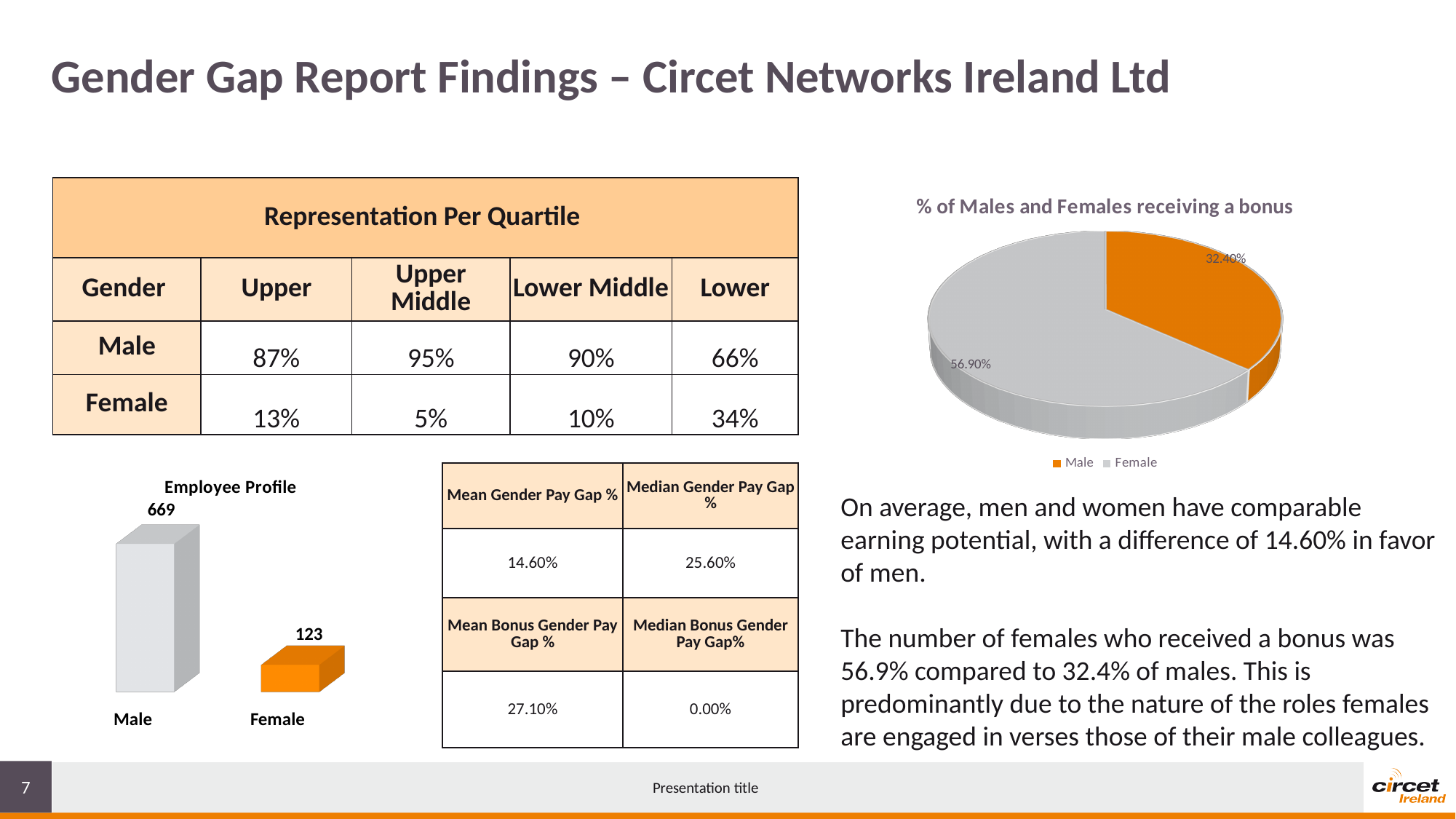
In the 'Employee Profile' chart, which category has the highest value? Male In the '% of Males and Females receiving a bonus' chart, what is the value for Male? 32.40% In the 'Employee Profile' chart, how many categories are shown? 2 In the 'Employee Profile' chart, what is the difference between the Male and Female values? 546 What kind of chart is the 'Employee Profile' chart? Bar chart In the '% of Males and Females receiving a bonus' chart, which category has the larger value, Male or Female? Female In the '% of Males and Females receiving a bonus' chart, what colour is the Male slice? Orange In the '% of Males and Females receiving a bonus' chart, what is the value for Female? 56.90% In the 'Employee Profile' chart, what is the value for Male? 669 What kind of chart is the '% of Males and Females receiving a bonus' chart? Pie chart In the 'Employee Profile' chart, what is the value for Female? 123 In the '% of Males and Females receiving a bonus' chart, how many entries does the legend list? 2